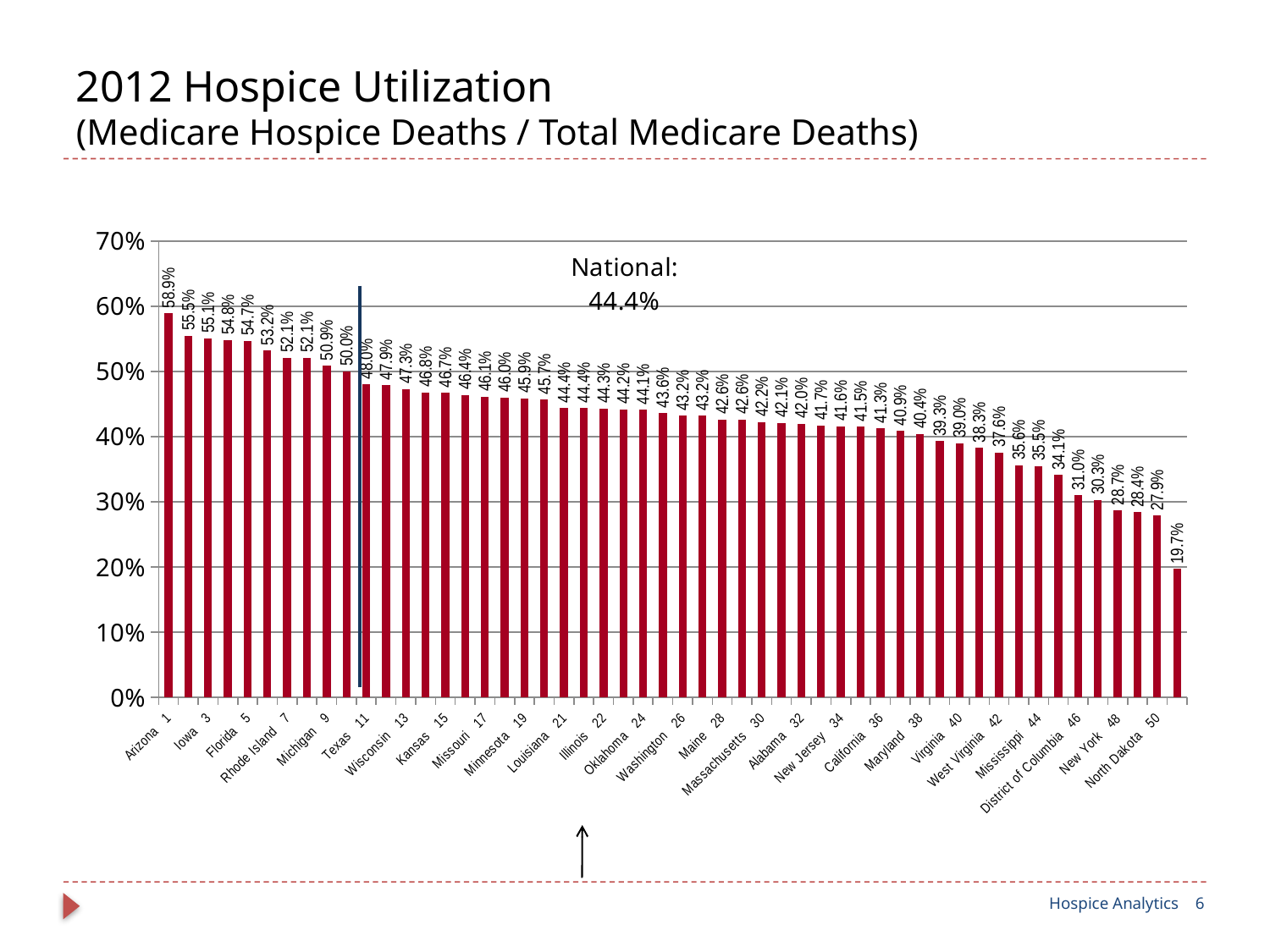
What national hospice utilization rate is noted on the chart? 44.4% What is the hospice utilization value for Arizona? 58.9% Do the bar values rise or fall from left to right across the chart? fall Which state has the highest hospice utilization on the chart? Arizona Is the value of the lowest bar greater or less than 20%? less What is the highest hospice utilization value shown on the chart? 58.9% What kind of chart is shown on the slide? bar chart What is the lowest hospice utilization value shown on the chart? 19.7% What is the maximum value shown on the vertical axis? 70% What is the difference between the highest bar value (58.9%) and the lowest bar value (19.7%)? 39.2 percentage points What is the title of the chart on the slide? 2012 Hospice Utilization (Medicare Hospice Deaths / Total Medicare Deaths) Is the value for Arizona greater or less than 50%? greater